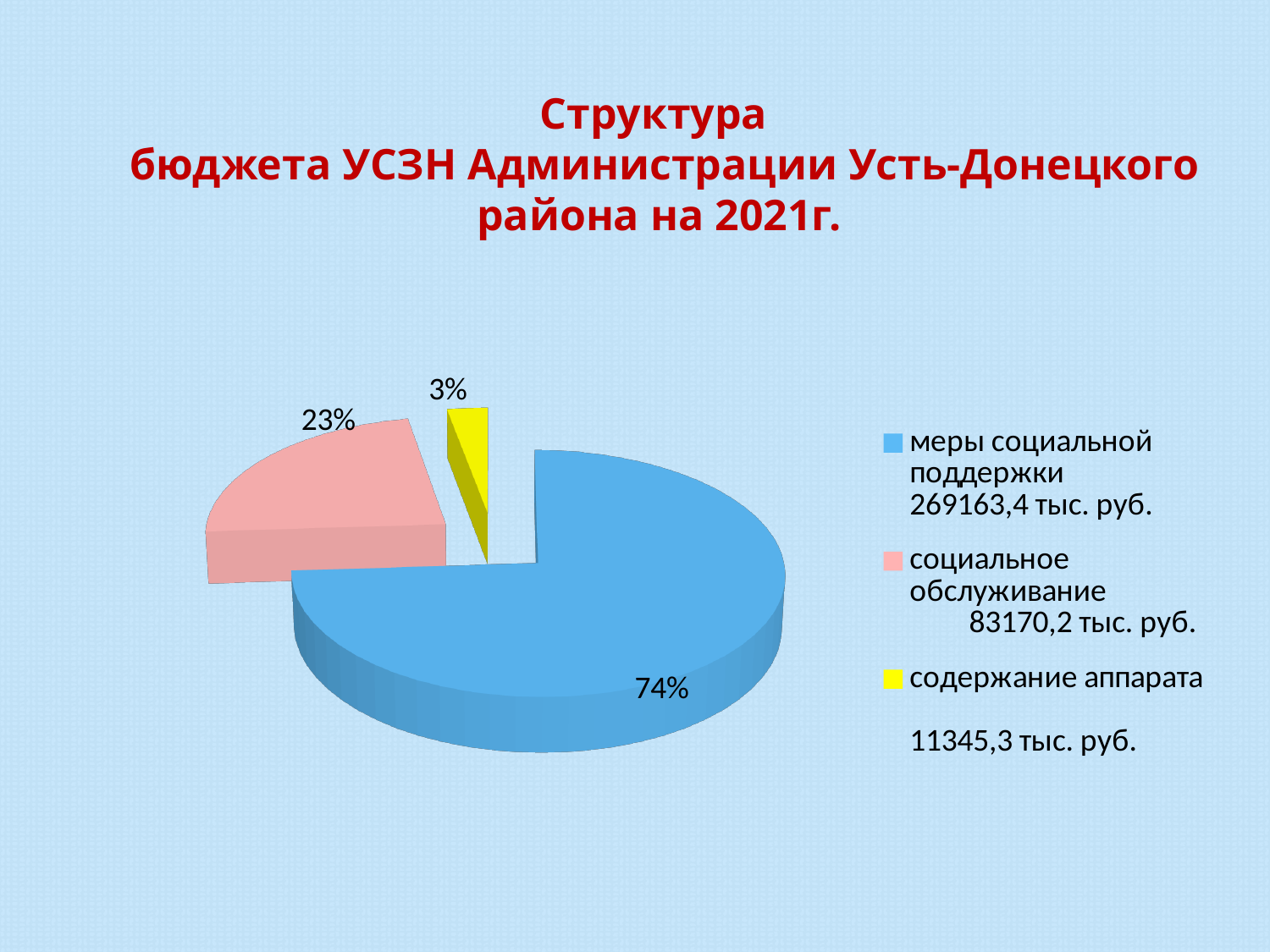
What is the difference in percentage points between the «меры социальной поддержки» slice and the «социальное обслуживание» slice? 51 percentage points What kind of chart is shown on the slide? Pie chart Which category has the largest slice of the pie? меры социальной поддержки Which category has the smallest slice of the pie? содержание аппарата What share of the pie does the slice for «социальное обслуживание» represent? 23% What colour is the slice for «социальное обслуживание»? Pink Which is larger: the share for «социальное обслуживание» or the share for «содержание аппарата»? социальное обслуживание According to the legend, what amount in тыс. руб. corresponds to «содержание аппарата»? 11345,3 тыс. руб. How many slices does the pie chart have? 3 What share of the pie does the slice for «содержание аппарата» represent? 3% According to the legend, what amount in тыс. руб. corresponds to «меры социальной поддержки»? 269163,4 тыс. руб. What share of the pie does the slice for «меры социальной поддержки» represent? 74%